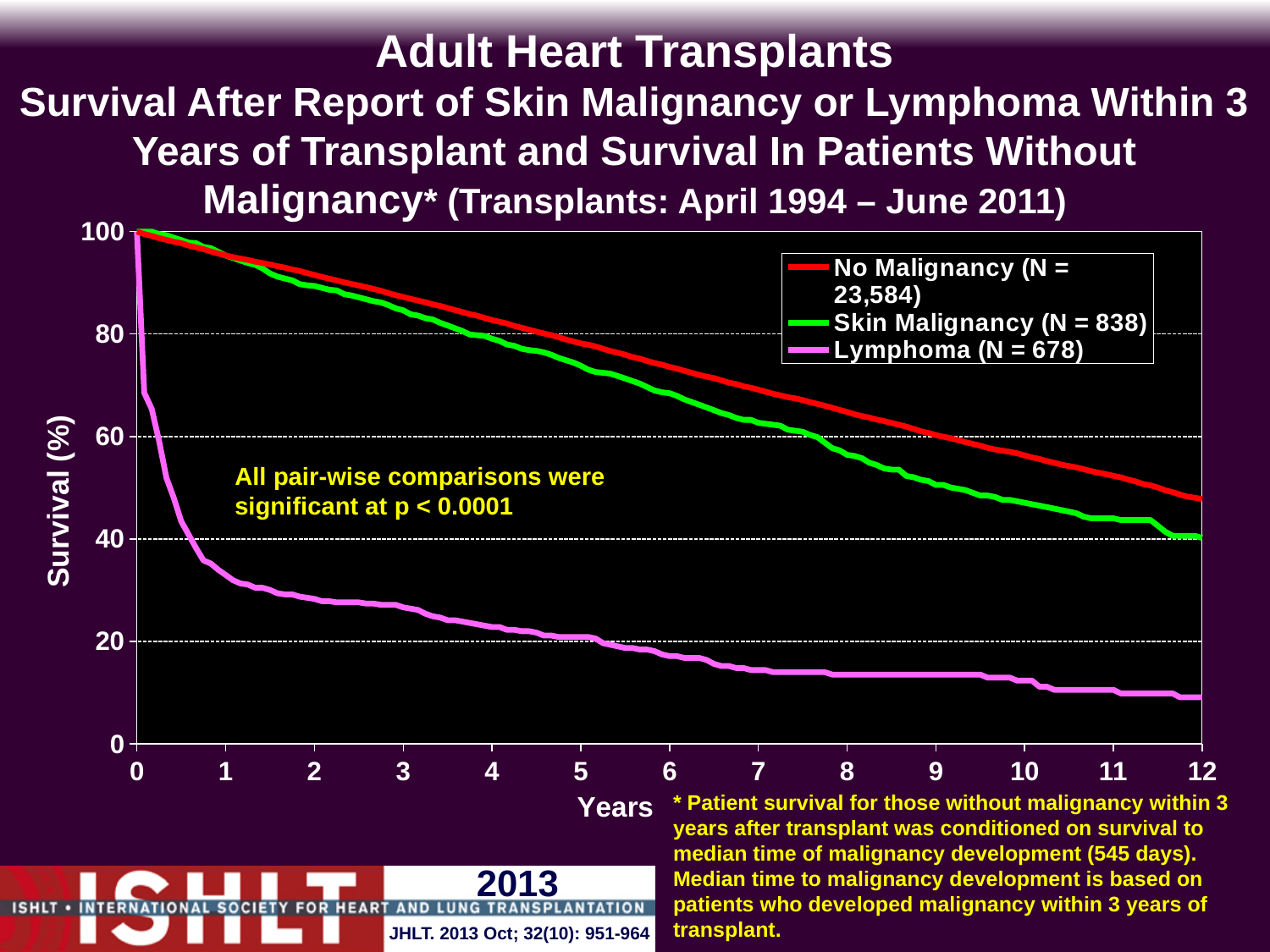
How many series does the legend list? 3 Which series has the highest survival at 12 years? No Malignancy (N = 23,584) Is the survival for No Malignancy at 6 years greater or less than 60? greater At 12 years, which is higher: survival for No Malignancy or for Skin Malignancy? No Malignancy Is the survival for Lymphoma at 12 years greater or less than 20? less Is the survival for Lymphoma at 1 year greater or less than 40? less Do the survival curves rise or fall as years since transplant increase? Fall Which series has the lowest survival at 12 years? Lymphoma (N = 678) What is the label of the y axis? Survival (%) What kind of chart is shown on the slide? Line chart What is the sample size (N) shown in the legend for the Skin Malignancy series? 838